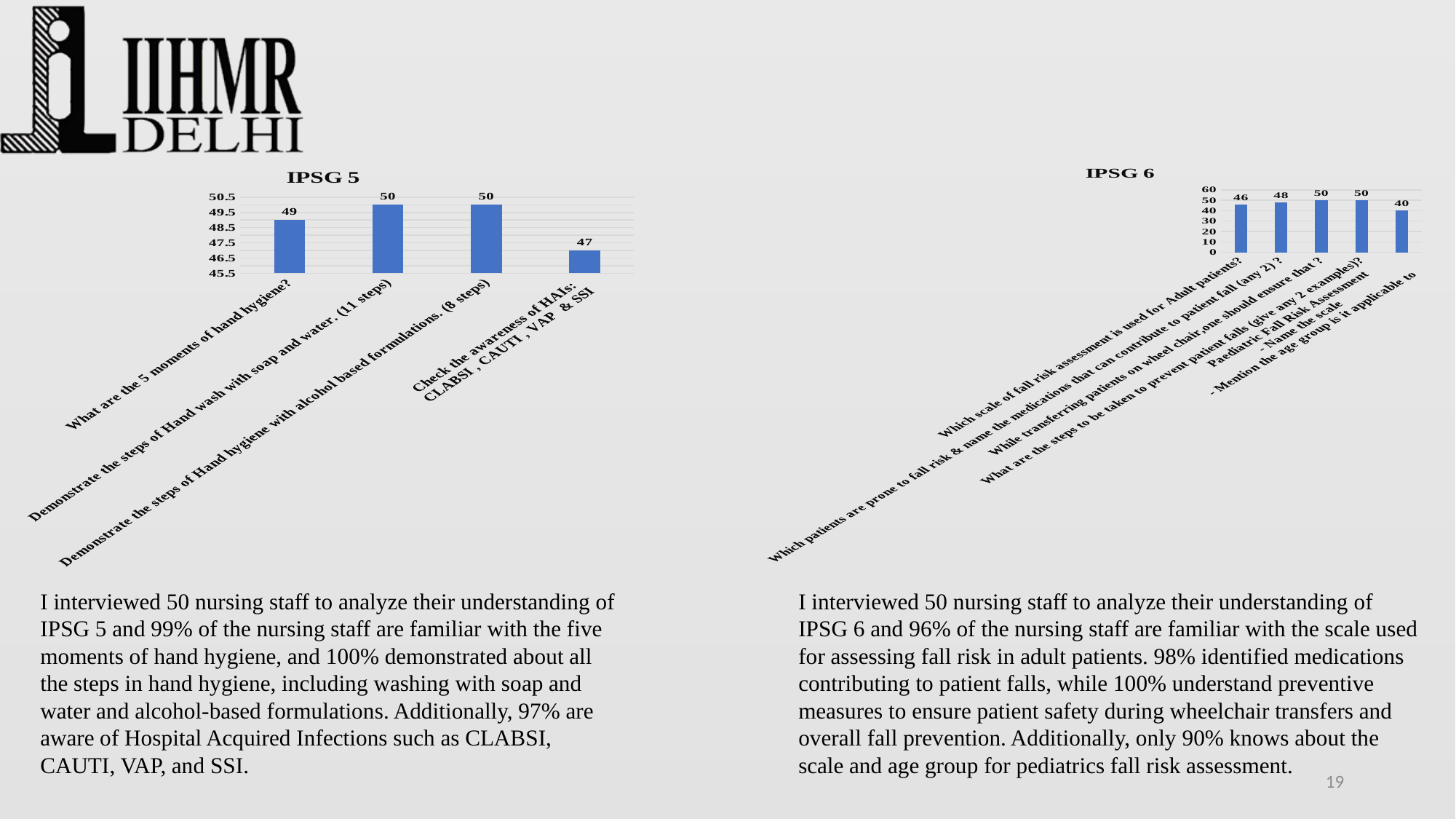
In the IPSG 5 chart, which category has the lowest value? Check the awareness of HAIs: CLABSI, CAUTI, VAP & SSI In the IPSG 5 chart, what is the value for "Check the awareness of HAIs: CLABSI, CAUTI, VAP & SSI"? 47 In the IPSG 6 chart, what is the difference between the value for "Which patients are prone to fall risk & name the medications that can contribute to patient fall (any 2)?" and the value for the Paediatric Fall Risk Assessment category? 8 What type of chart is the IPSG 5 chart? Bar chart In the IPSG 6 chart, what is the value for "Which scale of fall risk assessment is used for Adult patients?" 46 In the IPSG 6 chart, which is larger: the value for "Which scale of fall risk assessment is used for Adult patients?" or the value for "Which patients are prone to fall risk & name the medications that can contribute to patient fall (any 2)?" Which patients are prone to fall risk & name the medications that can contribute to patient fall (any 2)? In the IPSG 6 chart, which category has the lowest value? Paediatric Fall Risk Assessment - Name the scale - Mention the age group is it applicable to How many categories are shown in the IPSG 6 chart? 5 In the IPSG 5 chart, what is the value for "What are the 5 moments of hand hygiene?" 49 In the IPSG 5 chart, what is the difference between the value for "Demonstrate the steps of Hand wash with soap and water. (11 steps)" and the value for "Check the awareness of HAIs: CLABSI, CAUTI, VAP & SSI"? 3 How many categories are shown in the IPSG 5 chart? 4 In the IPSG 6 chart, what is the value for the Paediatric Fall Risk Assessment category? 40